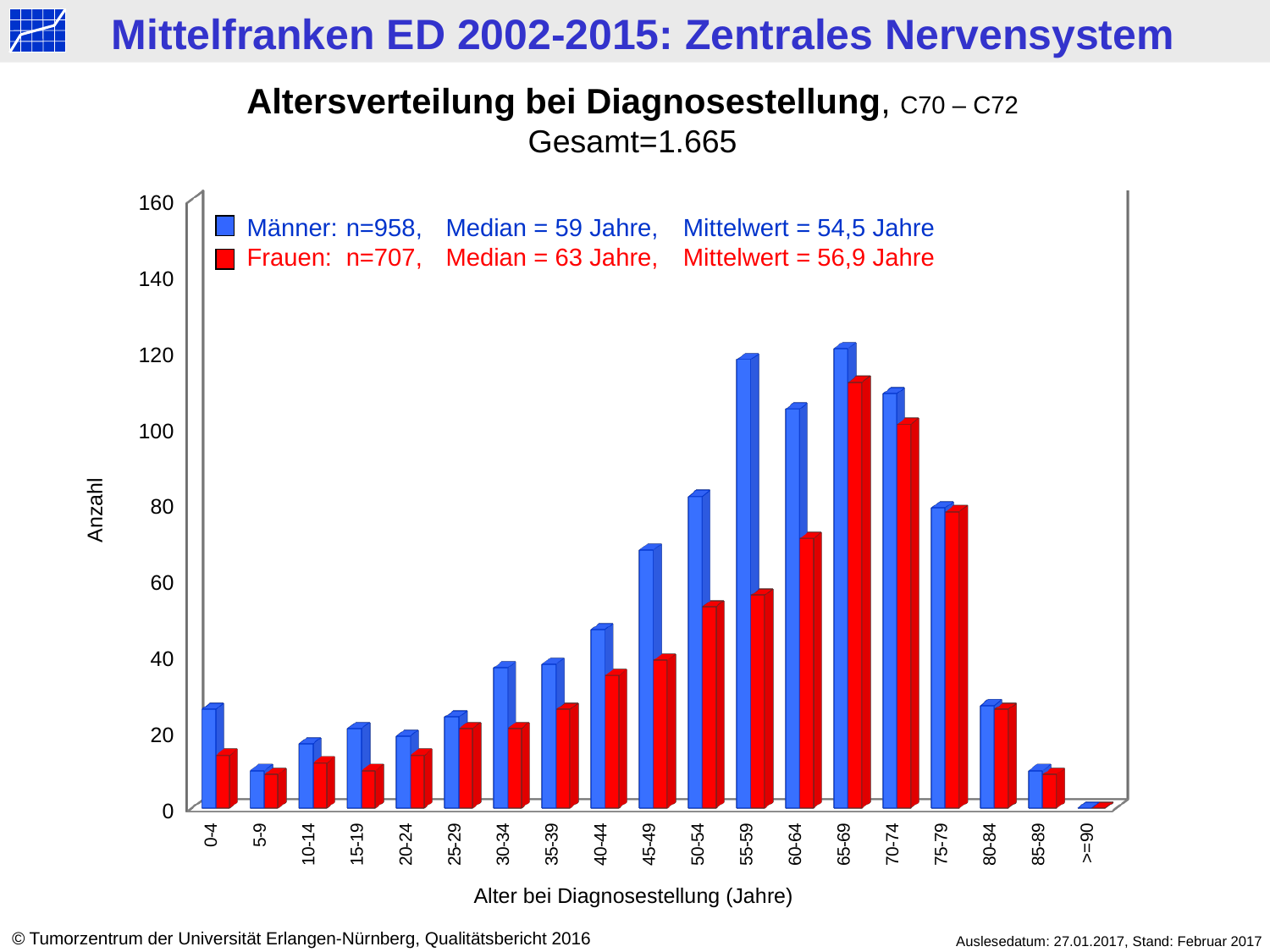
How many age categories are shown on the x axis? 19 What kind of chart is shown on the slide? bar chart In the 45-49 age group, which series has the larger value, Männer or Frauen? Männer Is the value for Männer in the 55-59 age group greater or less than 100? greater Is the value for Männer in the 0-4 age group greater or less than 20? greater Which age group has the highest value for Frauen? 65-69 How many series does the legend list? 2 Is the value for Frauen in the 50-54 age group greater or less than 60? less Do the values for Männer rise or fall from the 25-29 age group to the 55-59 age group? rise According to the legend, what is the median age for Frauen? 63 Jahre Which age group has the lowest value for Männer? >=90